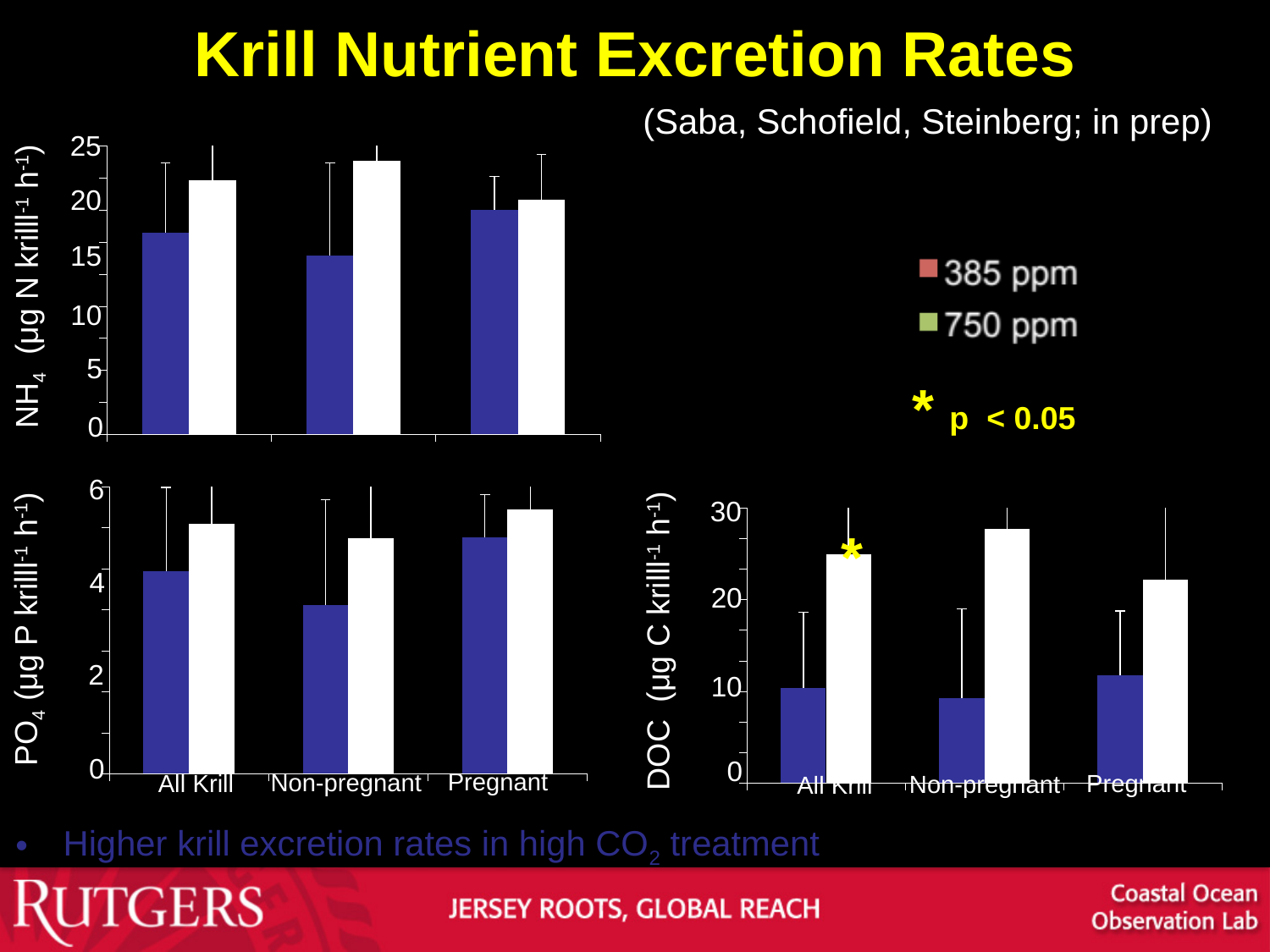
In the DOC chart at the bottom right, which is larger for All Krill, the 385 ppm value or the 750 ppm value? 750 ppm In the NH4 chart at the top left, is the 385 ppm value for Non-pregnant greater or less than 20? less In the DOC chart at the bottom right, which category has the highest 750 ppm value? Non-pregnant What kind of chart is the NH4 chart at the top left of the slide? bar chart How many categories are shown on the x axis of the DOC chart at the bottom right? 3 What are the two series named in the legend? 385 ppm and 750 ppm In the PO4 chart at the bottom left, is the 385 ppm value for Non-pregnant greater or less than 4? less According to the key on the slide, what does the yellow asterisk on the DOC chart indicate? p < 0.05 In the DOC chart at the bottom right, is the 750 ppm value for Non-pregnant greater or less than 20? greater How many series does the legend on the slide list? 2